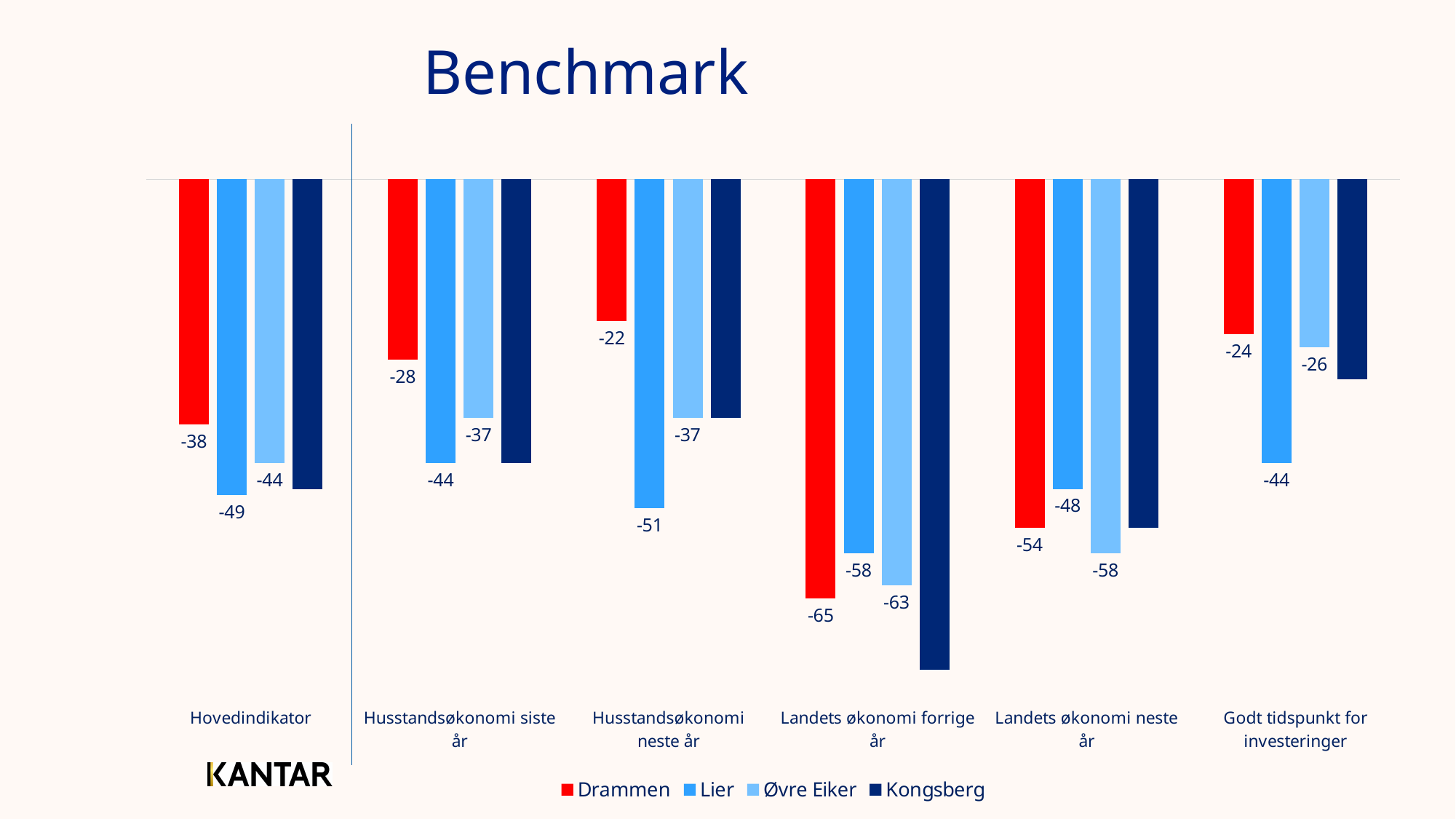
How many categories are shown on the x axis? 6 Which series has the lowest value in the Landets økonomi forrige år category? Kongsberg What is the value for Drammen in the Hovedindikator category? -38 What is the difference between the Lier and Drammen values in the Hovedindikator category? 11 What is the value for Øvre Eiker in the Landets økonomi forrige år category? -63 Which is larger in the Landets økonomi neste år category, the value for Lier or the value for Øvre Eiker? Lier What is the value for Lier in the Husstandsøkonomi neste år category? -51 In which category does Drammen have its highest value? Husstandsøkonomi neste år What kind of chart is shown on the slide? Bar chart How many series does the legend list? 4 What is the value for Drammen in the Godt tidspunkt for investeringer category? -24 In which category does Drammen have its lowest value? Landets økonomi forrige år